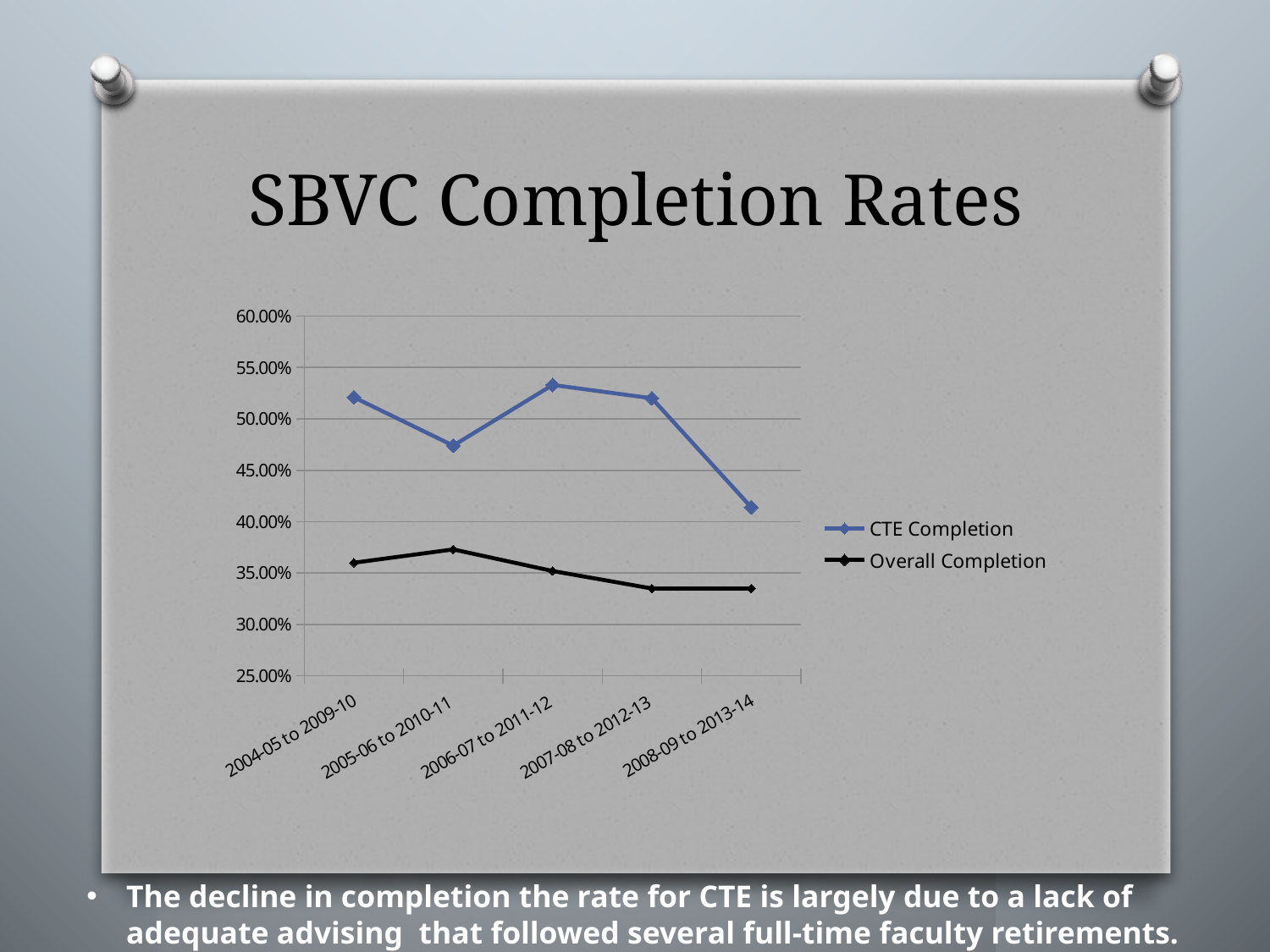
Which period has the lowest CTE Completion rate? 2008-09 to 2013-14 What kind of chart is shown on the slide? Line chart Which period has the highest CTE Completion rate? 2006-07 to 2011-12 Which period has the highest Overall Completion rate? 2005-06 to 2010-11 Which series is higher in 2004-05 to 2009-10, CTE Completion or Overall Completion? CTE Completion Is the CTE Completion rate for 2008-09 to 2013-14 greater or less than 45.00%? less How many series does the legend list? 2 Does the CTE Completion rate rise or fall from the first period to the last period? Fall Is the Overall Completion rate for 2007-08 to 2012-13 greater or less than 35.00%? less Is the CTE Completion rate for 2005-06 to 2010-11 greater or less than 50.00%? less What is the title of the chart? SBVC Completion Rates How many time periods are plotted along the x axis? 5